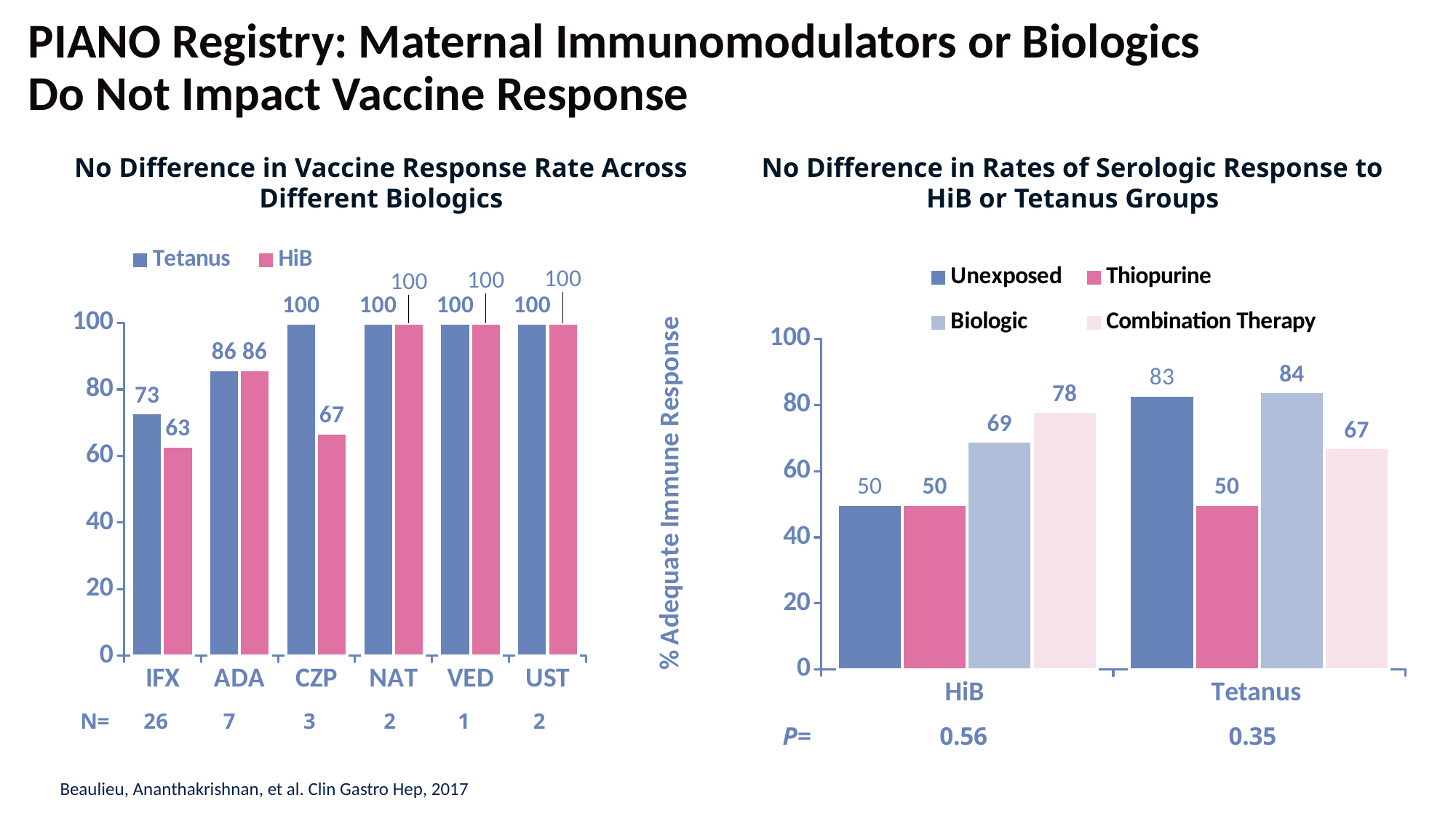
In the right chart (No Difference in Rates of Serologic Response to HiB or Tetanus Groups), how many series does the legend list? 4 In the left chart (No Difference in Vaccine Response Rate Across Different Biologics), what is the HiB value for CZP? 67 In the left chart (No Difference in Vaccine Response Rate Across Different Biologics), how many biologics are shown on the x axis? 6 What kind of chart is the right chart (No Difference in Rates of Serologic Response to HiB or Tetanus Groups)? Bar chart In the left chart (No Difference in Vaccine Response Rate Across Different Biologics), what is the Tetanus value for IFX? 73 In the right chart (No Difference in Rates of Serologic Response to HiB or Tetanus Groups), which is larger: the Biologic value for HiB or the Combination Therapy value for Tetanus? Biologic value for HiB In the left chart (No Difference in Vaccine Response Rate Across Different Biologics), which biologic has the lowest HiB value? IFX In the left chart (No Difference in Vaccine Response Rate Across Different Biologics), what is the difference between the Tetanus and HiB values for CZP? 33 In the right chart (No Difference in Rates of Serologic Response to HiB or Tetanus Groups), what is the Combination Therapy value for HiB? 78 In the right chart (No Difference in Rates of Serologic Response to HiB or Tetanus Groups), what is the difference between the Unexposed values for Tetanus and HiB? 33 In the right chart (No Difference in Rates of Serologic Response to HiB or Tetanus Groups), which group has the highest value for Tetanus? Biologic In the left chart (No Difference in Vaccine Response Rate Across Different Biologics), how many series does the legend list? 2